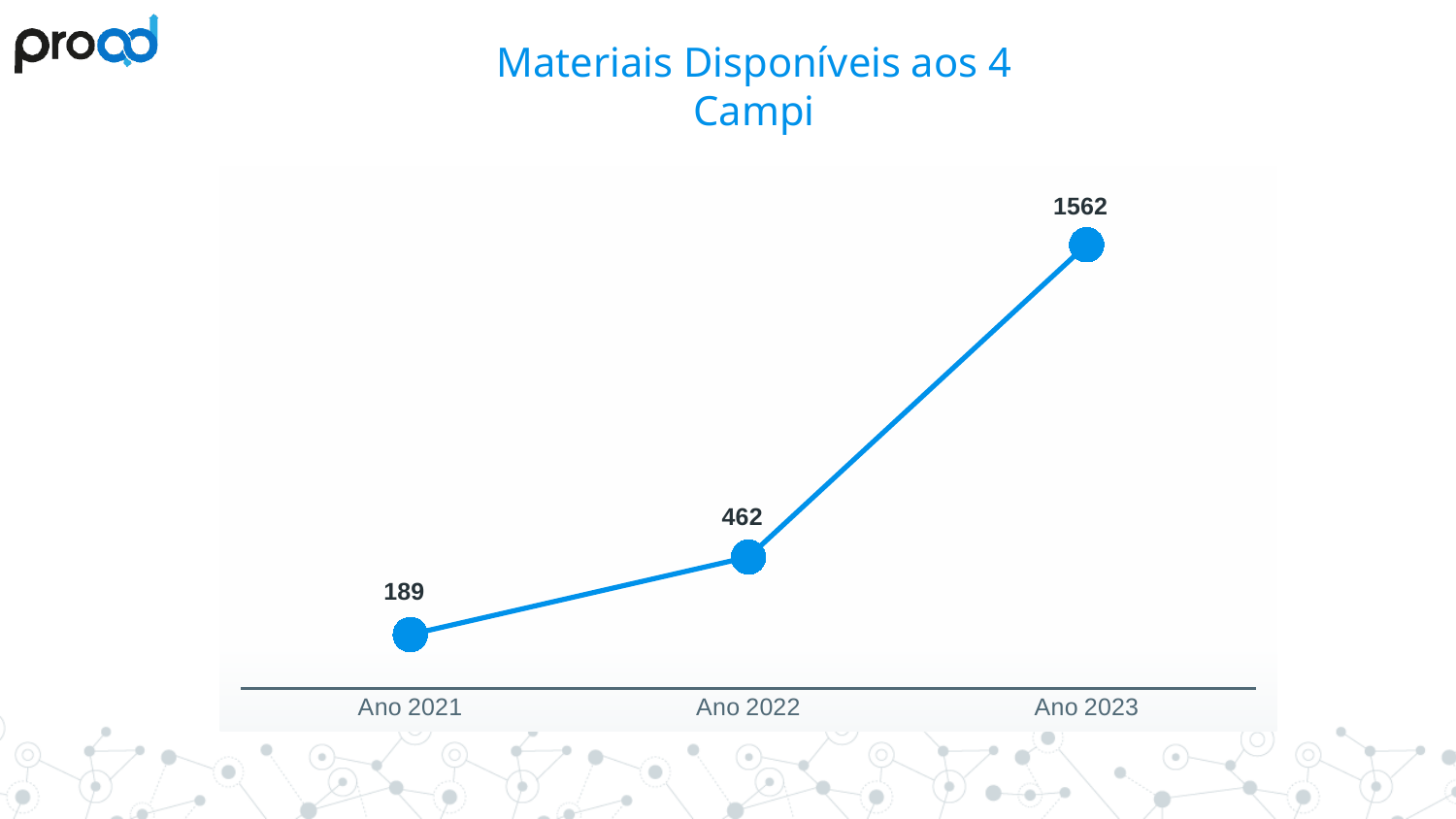
What is the difference between the values for Ano 2022 and Ano 2021? 273 Which year has the highest value? Ano 2023 Do the values rise or fall from Ano 2021 to Ano 2023? rise What kind of chart is shown on the slide? line chart What is the value for Ano 2023? 1562 What is the difference between the values for Ano 2023 and Ano 2022? 1100 What is the value for Ano 2021? 189 What is the value for Ano 2022? 462 How many data points are plotted on the chart? 3 Which is larger, the value for Ano 2022 or the value for Ano 2021? Ano 2022 What is the title of the chart? Materiais Disponíveis aos 4 Campi Which year has the lowest value? Ano 2021